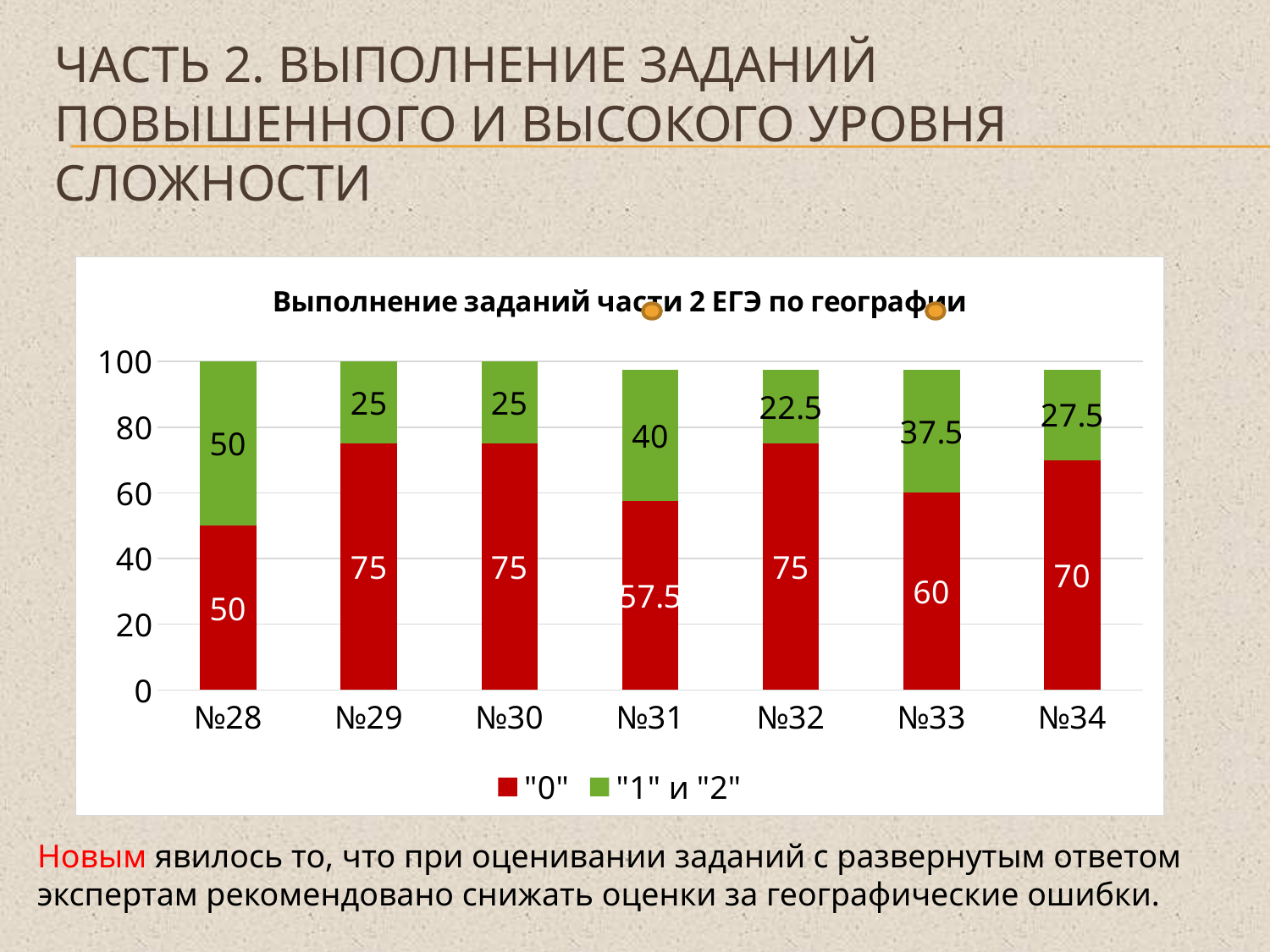
How many series does the legend list? 2 What is the value of the "1" и "2" series for №33? 37.5 What is the value of the "0" series for №34? 70 What type of chart is shown on the slide? Stacked bar chart Which is larger: the "1" и "2" value for №31 or for №34? №31 What is the difference between the "0" values for №29 and №33? 15 How many task categories are shown on the x axis? 7 Which category has the highest value for the "1" и "2" series? №28 What is the value of the "0" series for №31? 57.5 What is the title of the chart? Выполнение заданий части 2 ЕГЭ по географии Which category has the lowest value for the "1" и "2" series? №32 What is the total of the stacked bar for №31? 97.5